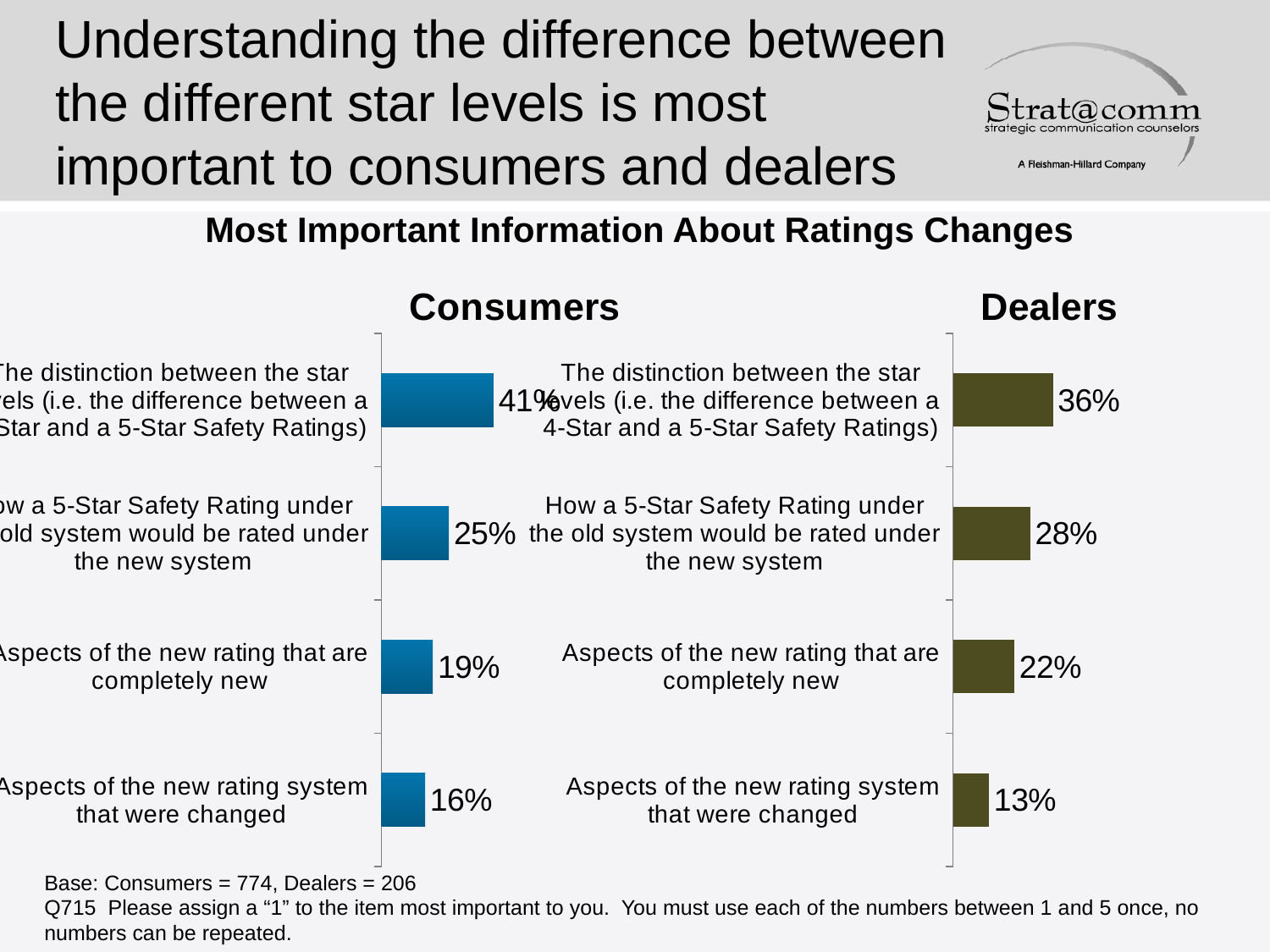
How many categories are shown in the Consumers chart? 4 In the Dealers chart, what is the difference between 'How a 5-Star Safety Rating under the old system would be rated under the new system' and 'Aspects of the new rating system that were changed'? 15% In the Dealers chart, what percentage is shown for 'How a 5-Star Safety Rating under the old system would be rated under the new system'? 28% In the Consumers chart, what percentage is shown for 'The distinction between the star levels'? 41% What is the title shown above the two charts? Most Important Information About Ratings Changes In the Consumers chart, what percentage is shown for 'Aspects of the new rating system that were changed'? 16% In the Dealers chart, what percentage is shown for 'Aspects of the new rating that are completely new'? 22% For 'Aspects of the new rating that are completely new', which is larger: the Consumers value or the Dealers value? Dealers What type of chart is used for the Dealers data? Bar chart In the Consumers chart, which category has the lowest value? Aspects of the new rating system that were changed In the Dealers chart, which category has the highest value? The distinction between the star levels (i.e. the difference between a 4-Star and a 5-Star Safety Ratings) What is the difference between the Consumers value and the Dealers value for 'The distinction between the star levels'? 5%